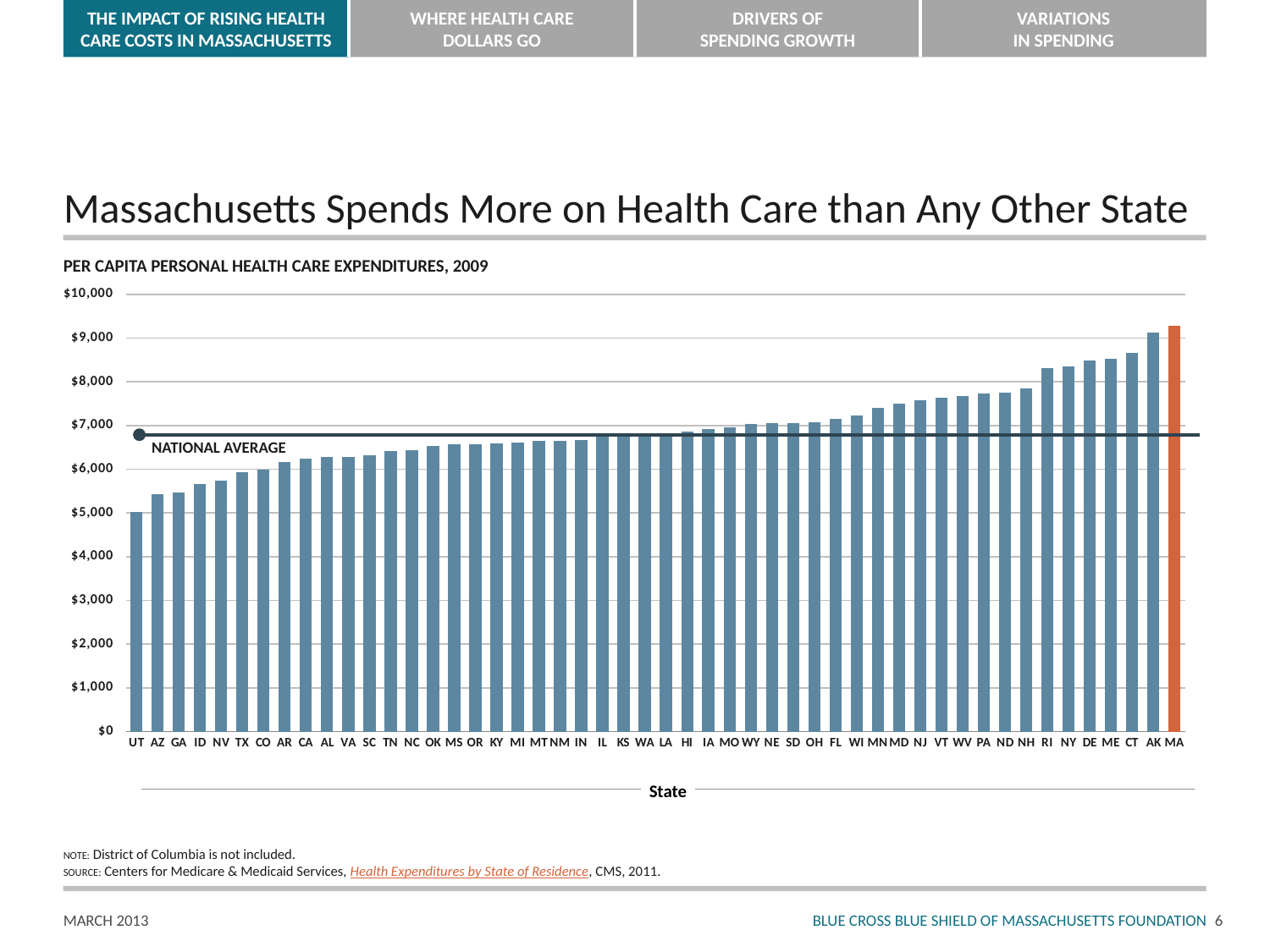
What kind of chart is shown on the slide? Bar chart Is the value for CT greater or less than $8,000? greater What is the title printed above the chart? PER CAPITA PERSONAL HEALTH CARE EXPENDITURES, 2009 Is the value for UT greater or less than $6,000? less How many states are shown on the x axis of the chart? 50 Which state's bar is highlighted in orange in the chart? MA Which state has the lowest per capita personal health care expenditure in the chart? UT Which state has the highest per capita personal health care expenditure in the chart? MA Is the value for MA greater or less than $9,000? greater Which state has a higher per capita expenditure, NY or AZ? NY Do the bar values rise or fall moving from left to right along the x axis? Rise